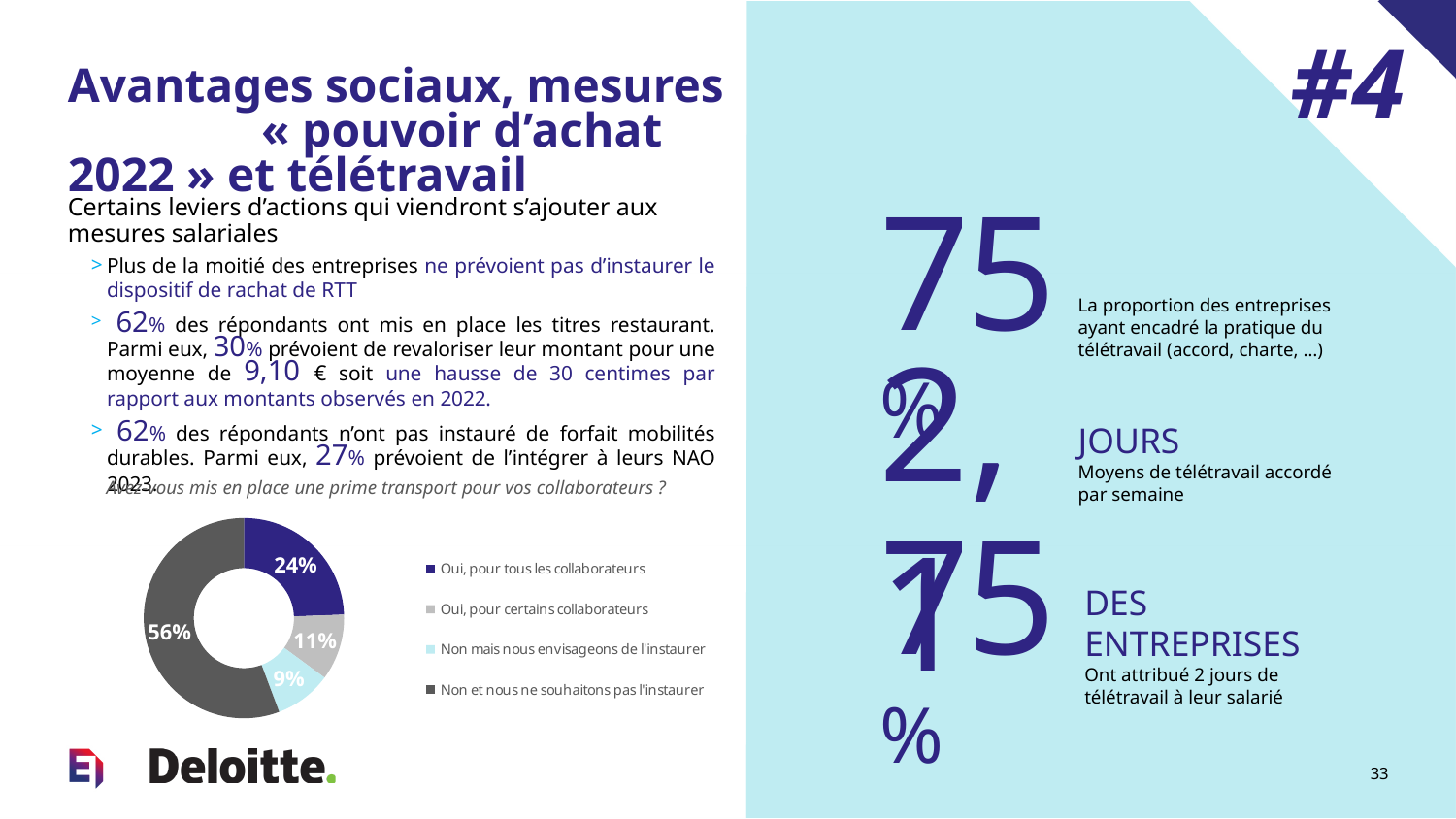
Which response has the largest share of the pie? Non et nous ne souhaitons pas l'instaurer What kind of chart is shown on the slide? Pie chart (donut) What percentage of respondents answered "Non mais nous envisageons de l'instaurer"? 9% Which is larger: the share for "Oui, pour certains collaborateurs" or the share for "Non mais nous envisageons de l'instaurer"? Oui, pour certains collaborateurs What percentage of respondents answered "Oui, pour certains collaborateurs"? 11% What percentage of respondents answered "Oui, pour tous les collaborateurs"? 24% What question does the pie chart's title ask? Avez-vous mis en place une prime transport pour vos collaborateurs ? What is the difference between the share for "Non et nous ne souhaitons pas l'instaurer" and the share for "Oui, pour tous les collaborateurs"? 32% What is the combined share of the two "Oui" responses? 35% What percentage of respondents answered "Non et nous ne souhaitons pas l'instaurer"? 56% How many slices does the pie chart have? 4 Which response has the smallest share of the pie? Non mais nous envisageons de l'instaurer